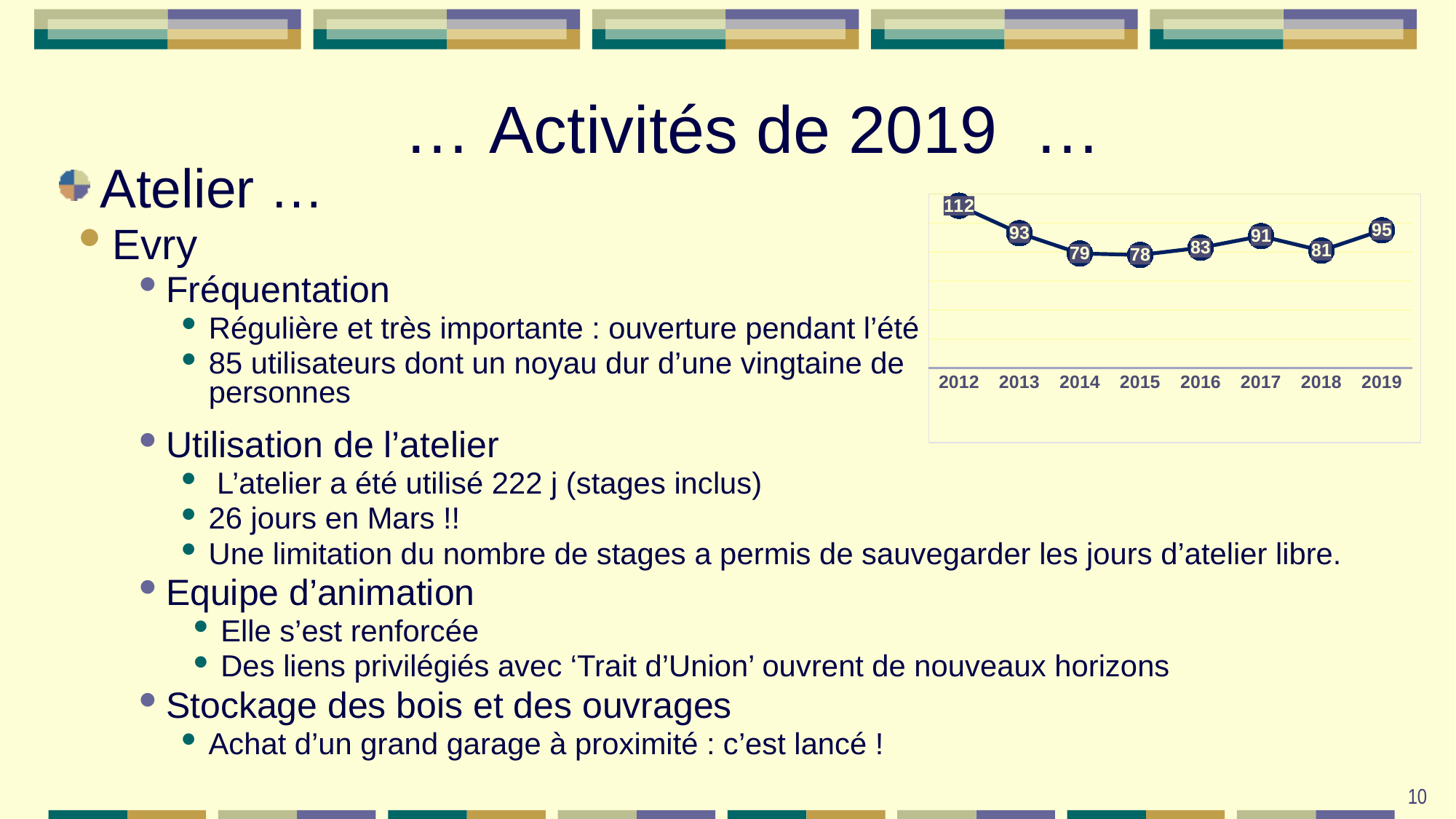
What is the difference between the values for 2019 and 2018 in the line chart? 14 What is the value for 2017 in the line chart? 91 What is the difference between the values for 2012 and 2013 in the line chart? 19 Which year has the lowest value in the line chart? 2015 What kind of chart is shown on the slide? line chart Does the value in the line chart rise or fall from 2012 to 2015? fall What is the value for 2015 in the line chart? 78 Which year has the highest value in the line chart? 2012 What is the value for 2012 in the line chart? 112 Which is larger in the line chart, the value for 2016 or the value for 2017? 2017 What is the value for 2019 in the line chart? 95 How many years are plotted in the line chart? 8